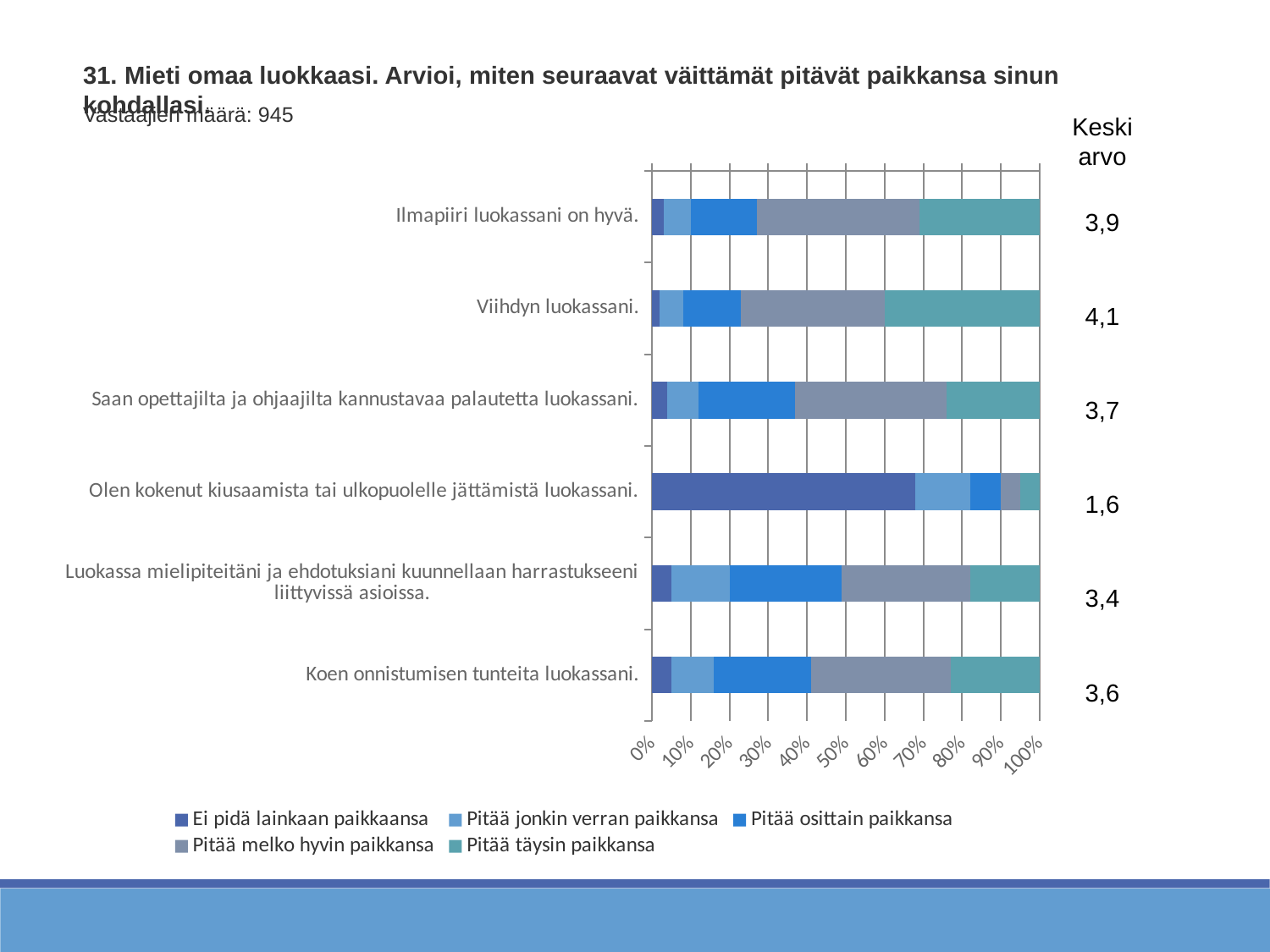
Which statement has the highest Keskiarvo (mean) value? Viihdyn luokassani. How many series does the legend list? 5 How many statements (categories) are plotted in the chart? 6 What kind of chart is shown on the slide? Stacked bar chart What is the difference between the highest and lowest Keskiarvo values shown? 2,5 Which statement has the lowest Keskiarvo (mean) value? Olen kokenut kiusaamista tai ulkopuolelle jättämistä luokassani. What is the Keskiarvo (mean) value shown for "Olen kokenut kiusaamista tai ulkopuolelle jättämistä luokassani."? 1,6 What is the Keskiarvo (mean) value shown for "Viihdyn luokassani."? 4,1 What is the number of respondents (Vastaajien määrä) stated on the slide? 945 Is the "Ei pidä lainkaan paikkaansa" share for "Olen kokenut kiusaamista tai ulkopuolelle jättämistä luokassani." greater or less than 60%? greater Which has a higher Keskiarvo value: "Ilmapiiri luokassani on hyvä." or "Saan opettajilta ja ohjaajilta kannustavaa palautetta luokassani."? Ilmapiiri luokassani on hyvä. What is the Keskiarvo (mean) value shown for "Koen onnistumisen tunteita luokassani."? 3,6